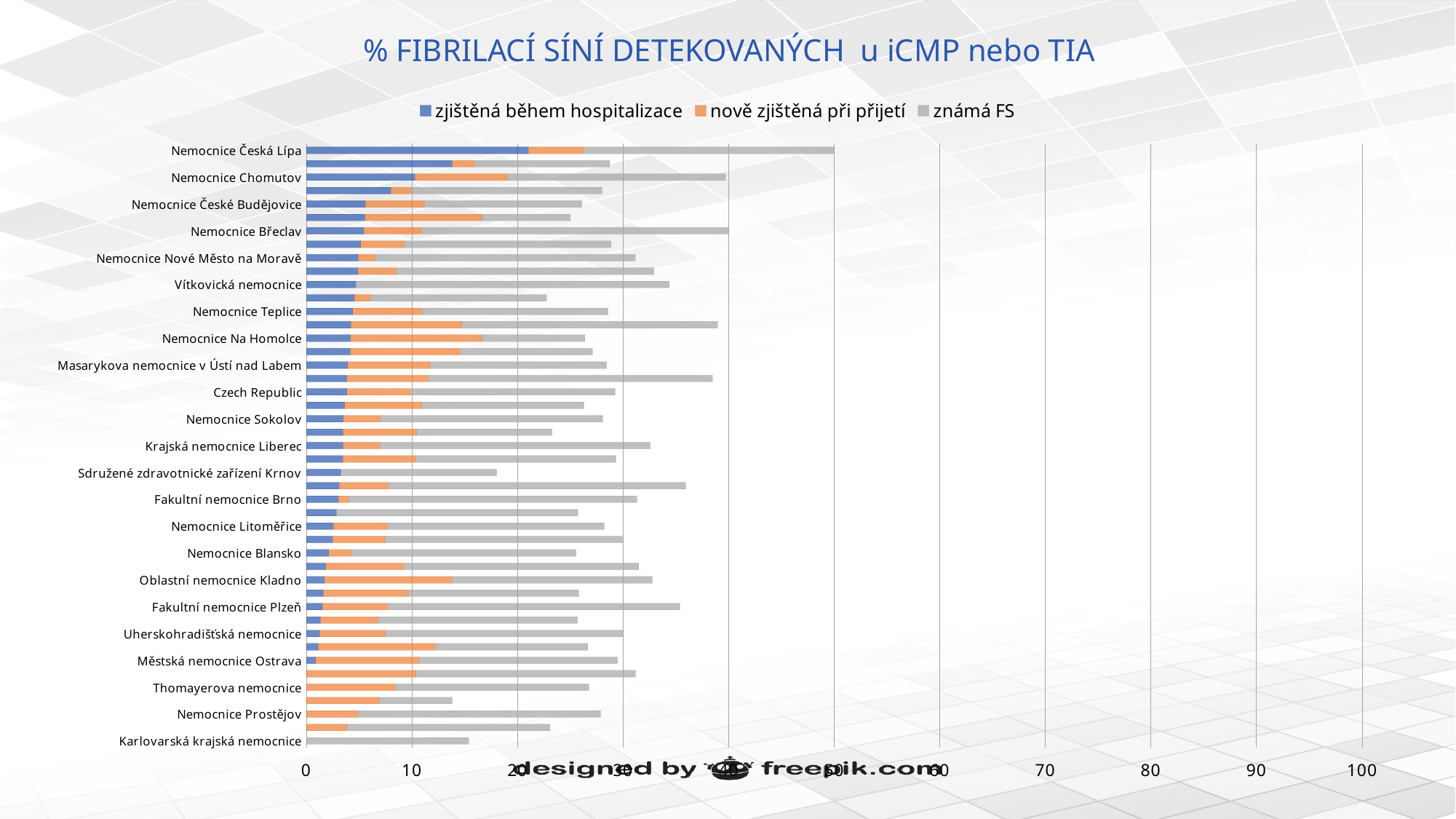
Which has the longer total bar, Nemocnice Česká Lípa or Karlovarská krajská nemocnice? Nemocnice Česká Lípa What is the title of the chart? % FIBRILACÍ SÍNÍ DETEKOVANÝCH u iCMP nebo TIA Which has the longer total bar, Vítkovická nemocnice or Nemocnice Blansko? Vítkovická nemocnice Is the total bar for Karlovarská krajská nemocnice greater or less than 20? less Which hospital has the longest total bar? Nemocnice Česká Lípa Is the total bar for Vítkovická nemocnice greater or less than 30? greater Is the total bar for Sdružené zdravotnické zařízení Krnov greater or less than 20? less Which hospital has the largest 'zjištěná během hospitalizace' (blue) segment? Nemocnice Česká Lípa What kind of chart is shown on the slide? Stacked bar chart How many series does the legend list? 3 Which series is shown in grey in the legend? známá FS